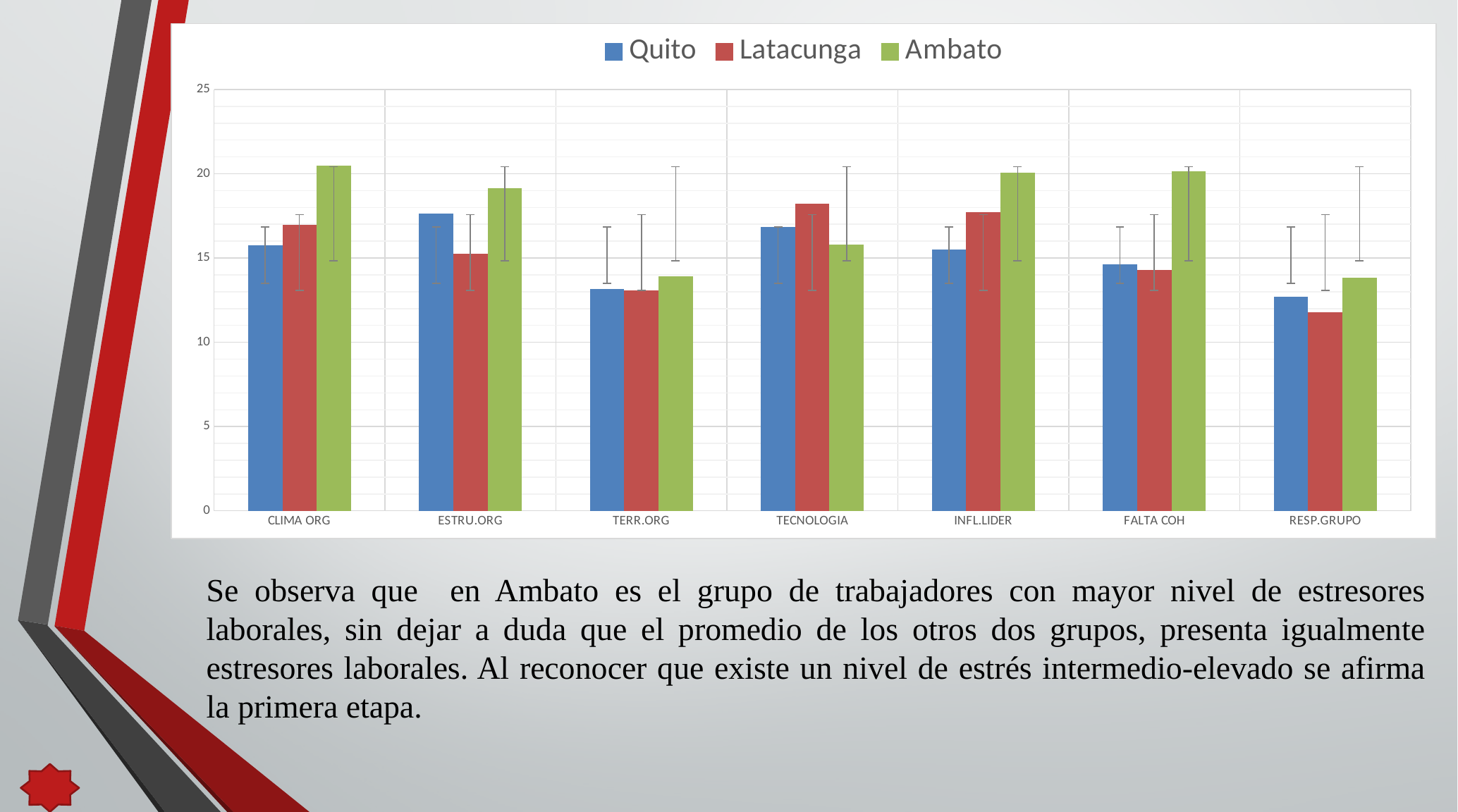
Which series has the lowest value for RESP.GRUPO? Latacunga Which series has the lowest value for ESTRU.ORG? Latacunga What kind of chart is shown on the slide? bar chart Which series has the highest value for CLIMA ORG? Ambato How many categories are shown along the x axis? 7 Is the Ambato value for ESTRU.ORG greater or less than 20? less How many series does the legend list? 3 Which colour represents the Ambato series in the legend? green For ESTRU.ORG, which is larger: the Quito value or the Latacunga value? Quito Is the Quito value for TERR.ORG greater or less than 15? less Is the Latacunga value for TECNOLOGIA greater or less than 15? greater Which series has the highest value for TECNOLOGIA? Latacunga